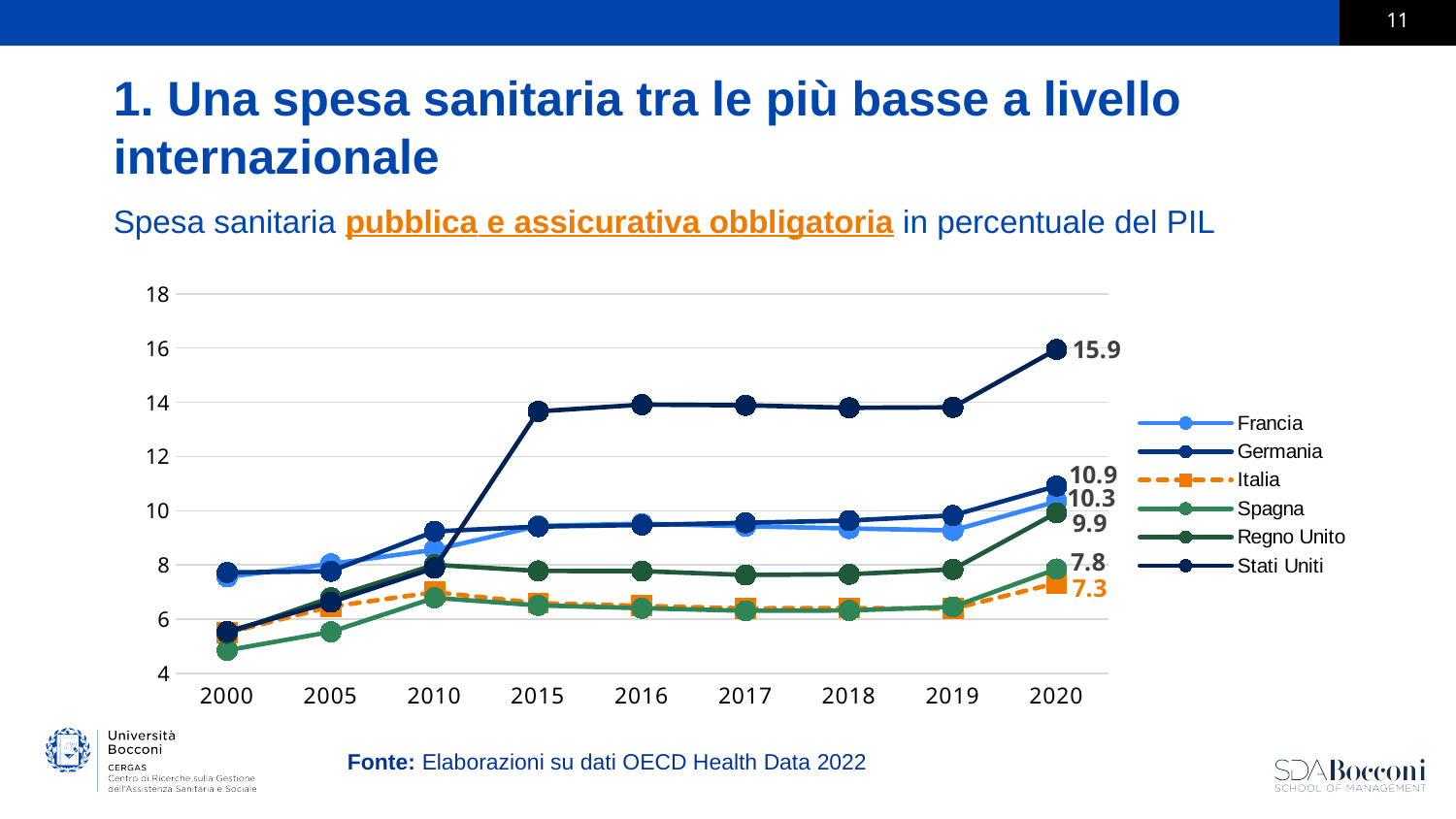
What is the value for Germania in 2020? 10.9 How many series does the legend list? 6 What kind of chart is shown on the slide? line chart Is the value for Stati Uniti in 2015 greater or less than 12? greater What is the value for Italia in 2020? 7.3 Which country has the lowest value in 2020? Italia Which country has the highest value in 2020? Stati Uniti Does the Stati Uniti line rise or fall from 2000 to 2020? rise How many years are shown on the x axis? 9 What is the value for Stati Uniti in 2020? 15.9 In 2020, which is larger: the value for Francia or the value for Regno Unito? Francia What is the difference between the 2020 values for Stati Uniti and Italia? 8.6